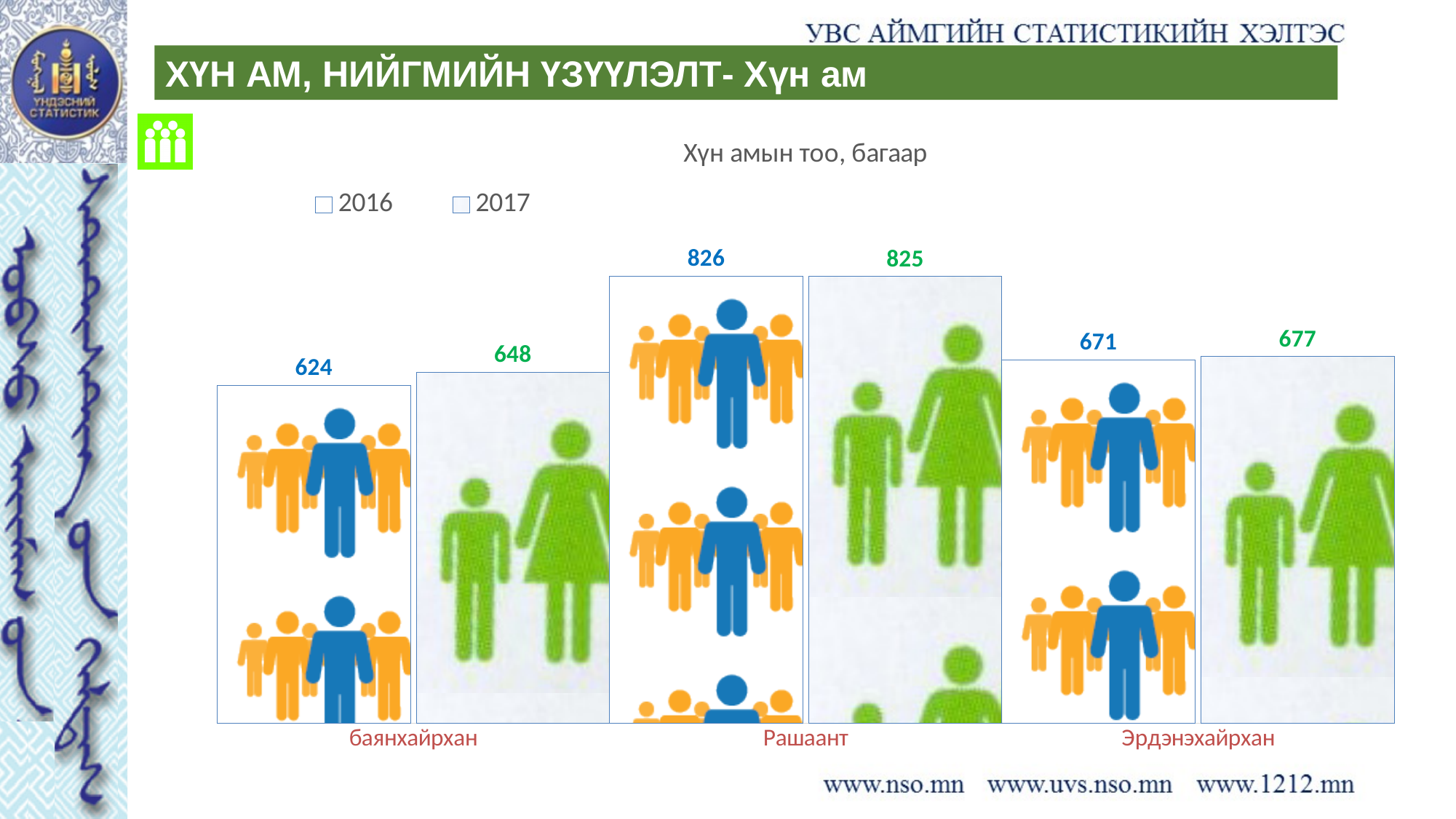
What is the 2016 value for баянхайрхан? 624 What is the title of the chart? Хүн амын тоо, багаар What is the difference between the 2017 and 2016 values for баянхайрхан? 24 How many series does the legend list? 2 What kind of chart is shown? bar chart Which category has the lowest 2016 value? баянхайрхан What is the 2017 value for баянхайрхан? 648 Which category has the highest 2017 value? Рашаант What is the 2017 value for Эрдэнэхайрхан? 677 What is the 2016 value for Рашаант? 826 Which is larger for Эрдэнэхайрхан, the 2016 value or the 2017 value? 2017 How many categories are shown on the x axis? 3